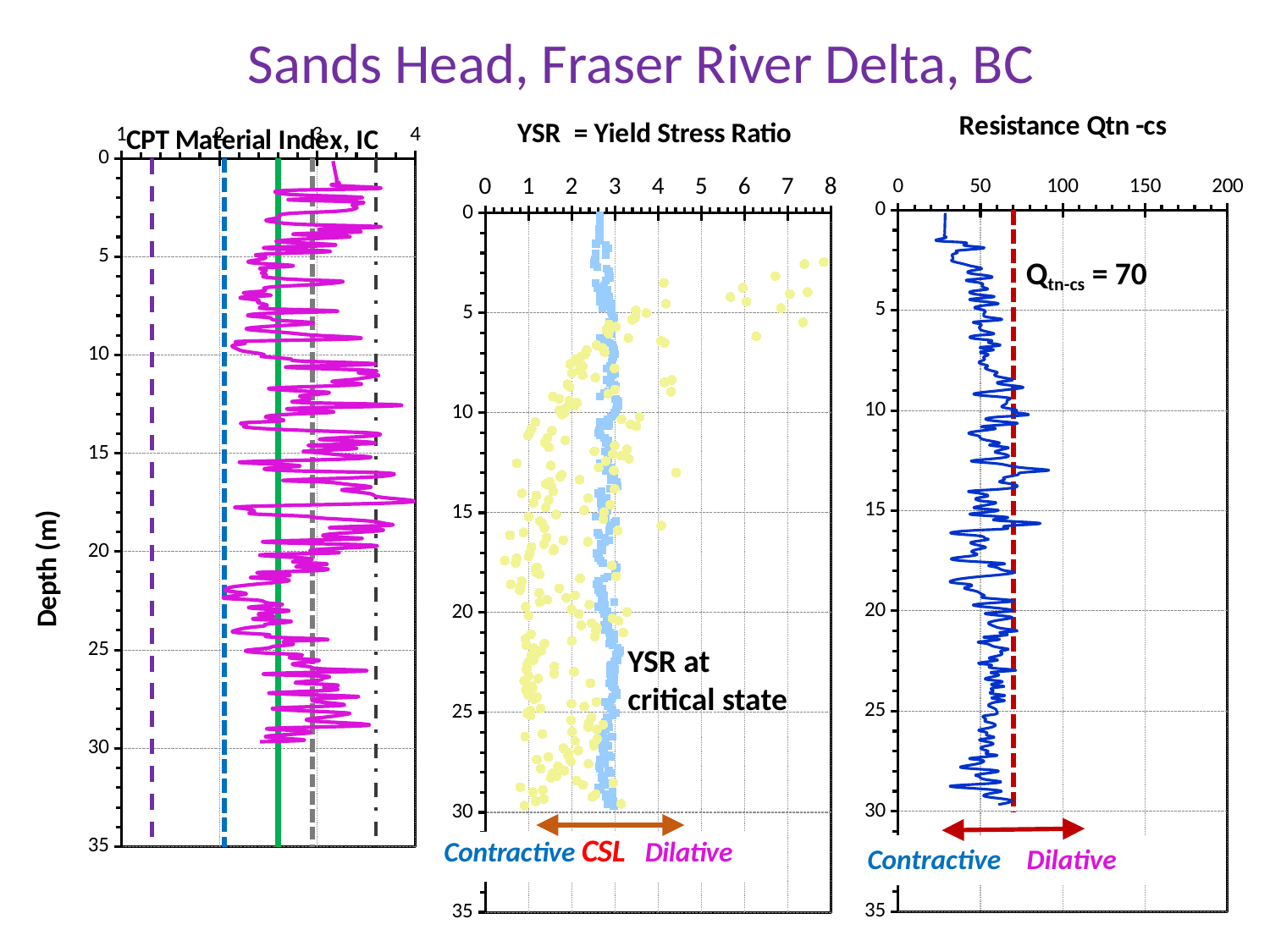
In the Resistance Qtn-cs chart, is the plotted resistance value at a depth of 13 m greater or less than 100? less How many charts are shown on the slide? 3 In the YSR = Yield Stress Ratio chart, is the YSR at critical state (blue points) greater or less than 2? greater In the Resistance Qtn-cs chart, what value does the red dashed vertical line represent according to the annotation? Qtn-cs = 70 What is the title of the middle chart? YSR = Yield Stress Ratio What is the maximum depth shown on the vertical axis of the CPT Material Index, IC chart? 35 In the Resistance Qtn-cs chart, is the plotted resistance value at a depth of 13 m greater or less than 50? greater What is the title of the right-hand chart? Resistance Qtn -cs What is the maximum value shown on the x axis of the YSR = Yield Stress Ratio chart? 8 What is the maximum value shown on the x axis of the Resistance Qtn-cs chart? 200 What kind of chart is the YSR = Yield Stress Ratio chart? scatter chart